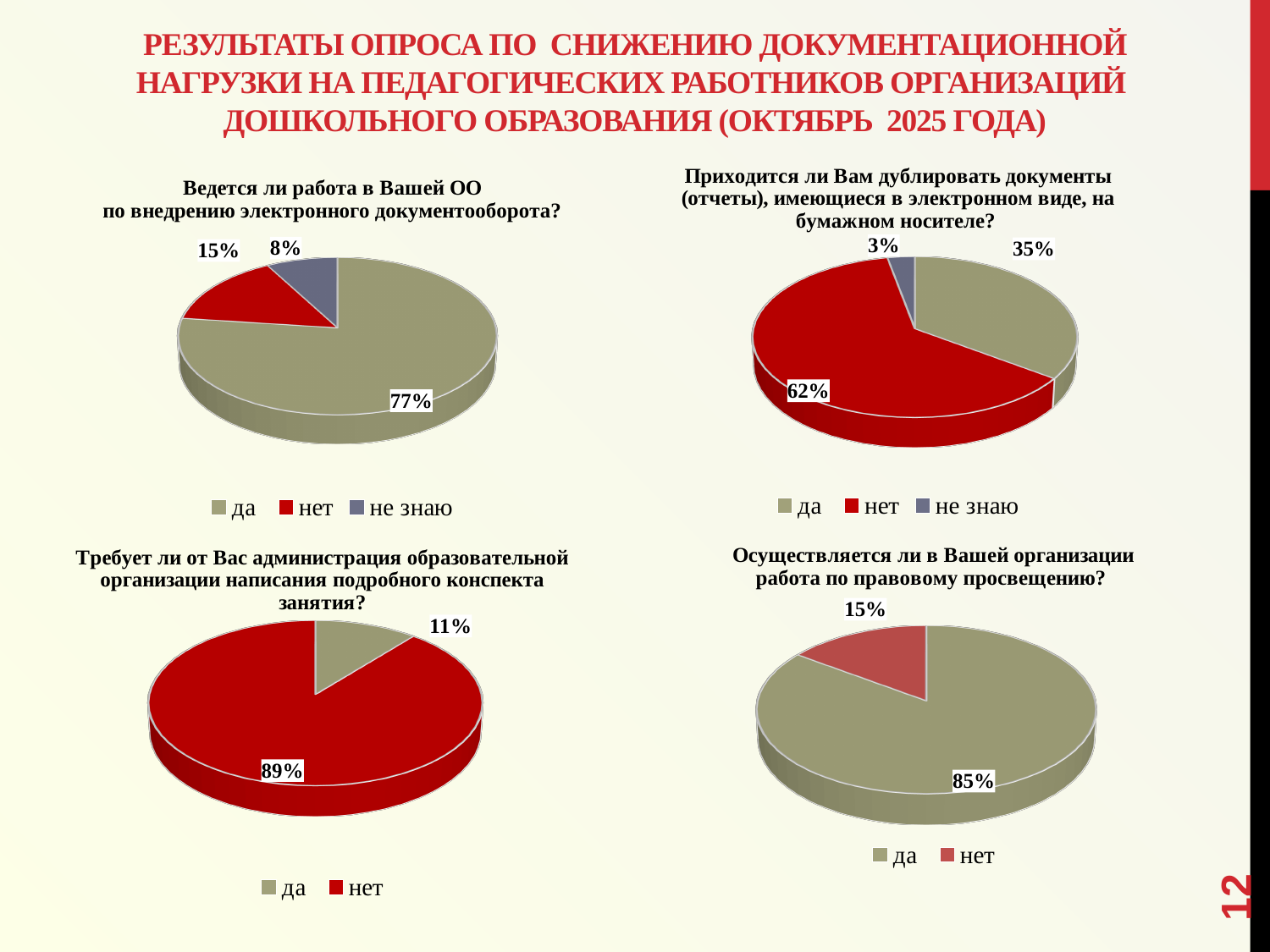
In the top-left pie chart (electronic document management), what share of respondents answered "не знаю"? 8% In the bottom-right pie chart (legal education work), which is larger, the "да" share or the "нет" share? да In the bottom-left pie chart (detailed lesson plan required by administration), which answer has the largest share? нет In the top-right pie chart (duplicating electronic documents on paper), what is the difference between the "нет" and "да" shares? 27% In the bottom-left pie chart (detailed lesson plan required by administration), what share of respondents answered "нет"? 89% How many slices does the top-left pie chart (electronic document management) have? 3 In the top-left pie chart (electronic document management), what share of respondents answered "да"? 77% In the bottom-right pie chart (legal education work), what share of respondents answered "да"? 85% What type of chart is used in the bottom-right chart (legal education work)? Pie chart In the top-right pie chart (duplicating electronic documents on paper), what share of respondents answered "нет"? 62% In the top-right pie chart (duplicating electronic documents on paper), which answer has the smallest share? не знаю How many entries does the legend of the bottom-left pie chart (detailed lesson plan required by administration) list? 2